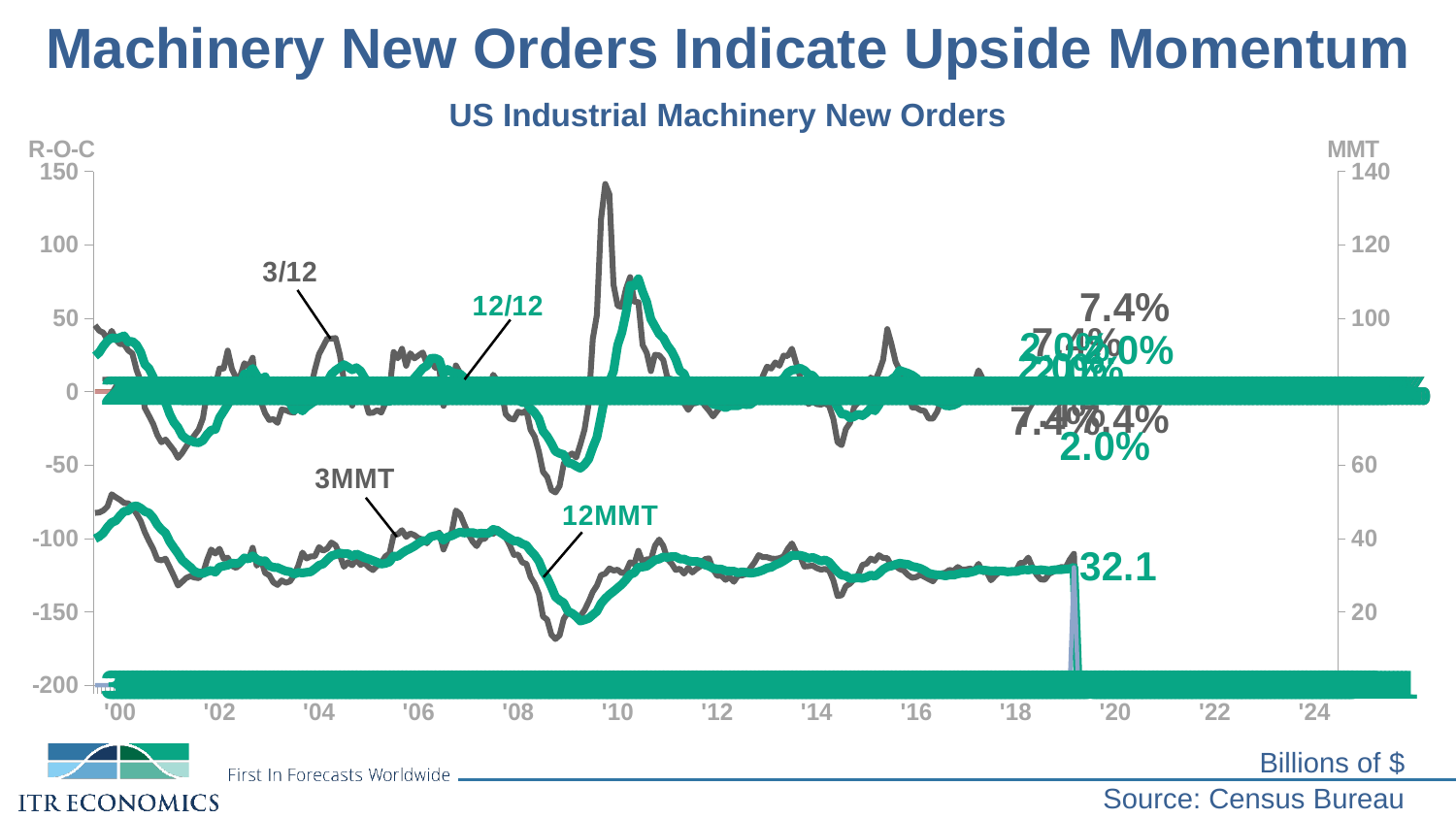
Is the peak of the 3/12 line around 2010 greater or less than 100 on the R-O-C axis? greater What is the highest tick value shown on the right MMT axis? 140 What kind of chart is shown on the slide? line chart What is the latest value labeled on the 12MMT line? 32.1 What is the title of the chart? US Industrial Machinery New Orders How many data series are labeled on the chart? 4 Is the trough of the 12MMT line around 2009 greater or less than 40 on the MMT axis? less At the 2010 peak, which line reaches higher, 3/12 or 12/12? 3/12 What is the first year label shown on the x axis? '00 What is the source cited for the chart data? Census Bureau What is the highest tick value shown on the left R-O-C axis? 150 Is the peak of the 12/12 line around 2010 greater or less than 50 on the R-O-C axis? greater